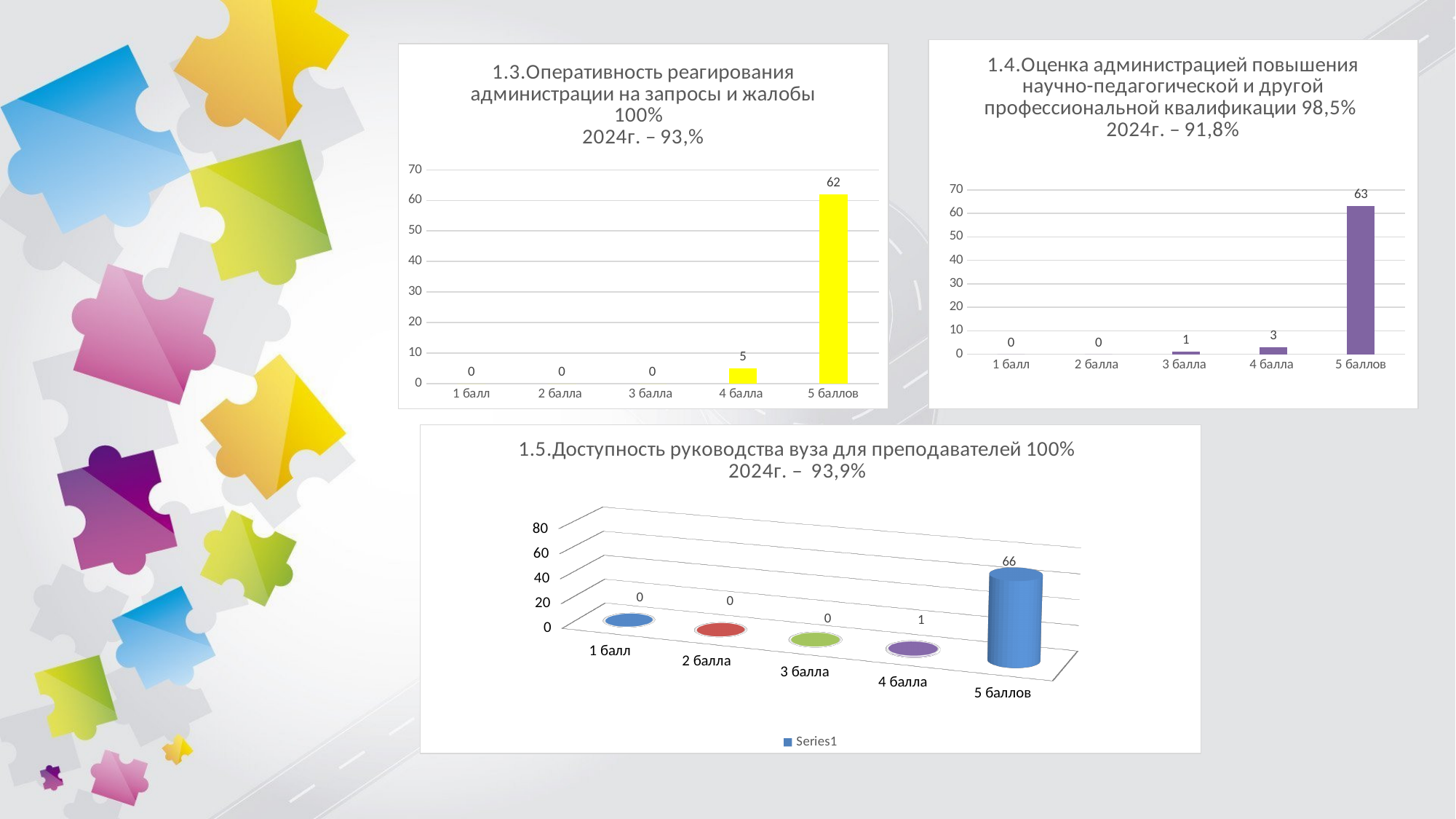
In the chart titled "1.4.Оценка администрацией повышения научно-педагогической и другой профессиональной квалификации", what is the value for 4 балла? 3 Which is larger: the value for 5 баллов in the chart titled "1.3.Оперативность реагирования администрации на запросы и жалобы" or the value for 5 баллов in the chart titled "1.5.Доступность руководства вуза для преподавателей"? 1.5.Доступность руководства вуза для преподавателей In the chart titled "1.5.Доступность руководства вуза для преподавателей", what is the value for 5 баллов? 66 In the chart titled "1.5.Доступность руководства вуза для преподавателей", how many series does the legend list? 1 In the chart titled "1.5.Доступность руководства вуза для преподавателей", what is the value for 4 балла? 1 In the chart titled "1.4.Оценка администрацией повышения научно-педагогической и другой профессиональной квалификации", which category has the highest value? 5 баллов In the chart titled "1.3.Оперативность реагирования администрации на запросы и жалобы", what is the value for 5 баллов? 62 In the chart titled "1.3.Оперативность реагирования администрации на запросы и жалобы", is the value for 5 баллов greater or less than 60? greater In the chart titled "1.4.Оценка администрацией повышения научно-педагогической и другой профессиональной квалификации", what is the difference between the values for 5 баллов and 4 балла? 60 In the chart titled "1.3.Оперативность реагирования администрации на запросы и жалобы", what is the value for 4 балла? 5 What type of chart is the chart titled "1.4.Оценка администрацией повышения научно-педагогической и другой профессиональной квалификации"? bar chart In the chart titled "1.5.Доступность руководства вуза для преподавателей", how many categories are shown on the x axis? 5